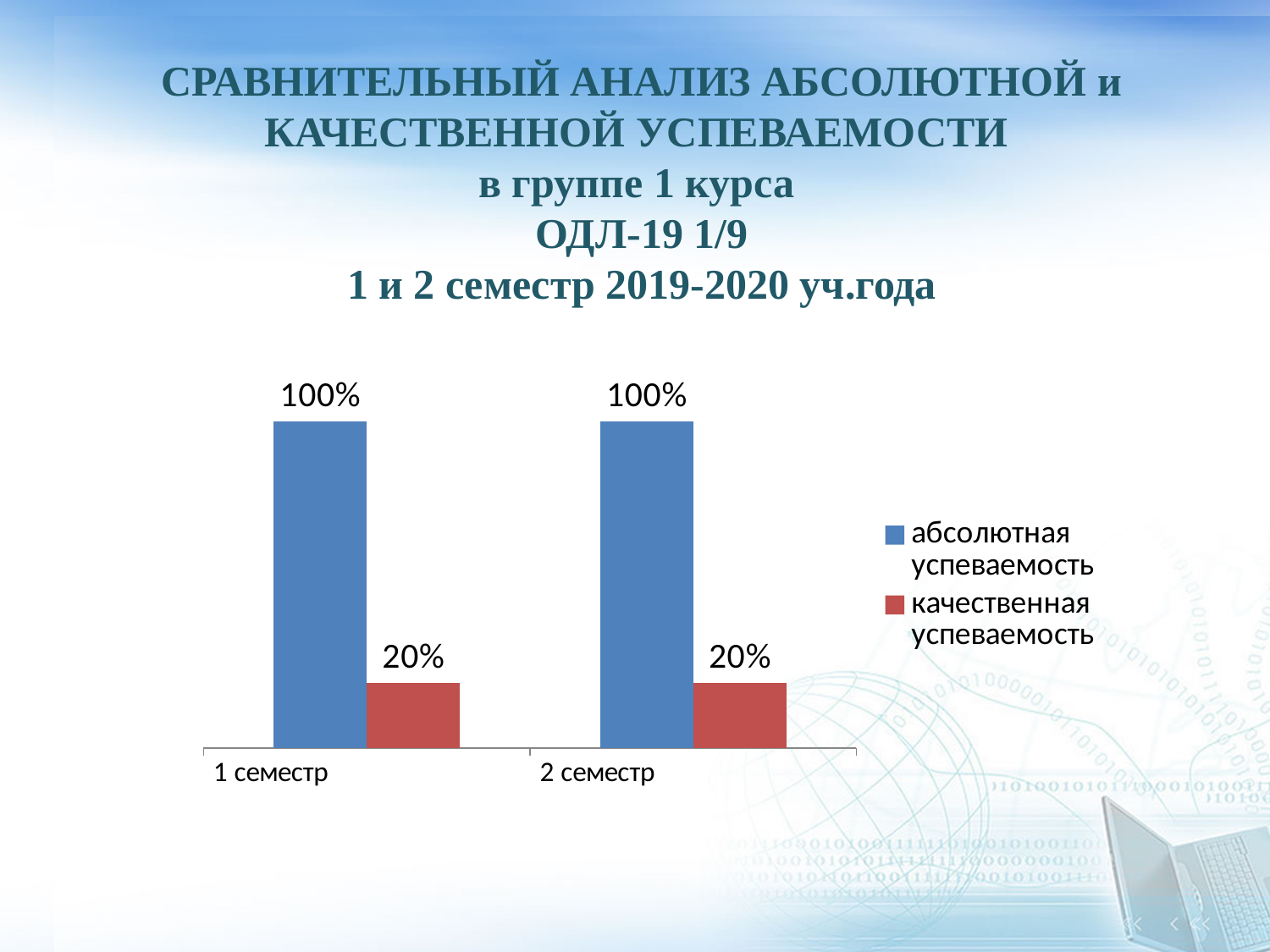
What is the value of качественная успеваемость for 1 семестр? 20% What colour are the bars for качественная успеваемость? red What kind of chart is shown on the slide? bar chart Does качественная успеваемость rise, fall or stay the same from 1 семестр to 2 семестр? stays the same What is the value of абсолютная успеваемость for 2 семестр? 100% What is the difference between абсолютная успеваемость and качественная успеваемость in 1 семестр? 80% Which series has the larger value in 2 семестр, абсолютная успеваемость or качественная успеваемость? абсолютная успеваемость How many categories are shown on the x axis? 2 What is the value of абсолютная успеваемость for 1 семестр? 100% Which series is shown in blue in the legend? абсолютная успеваемость How many series does the legend list? 2 What is the value of качественная успеваемость for 2 семестр? 20%